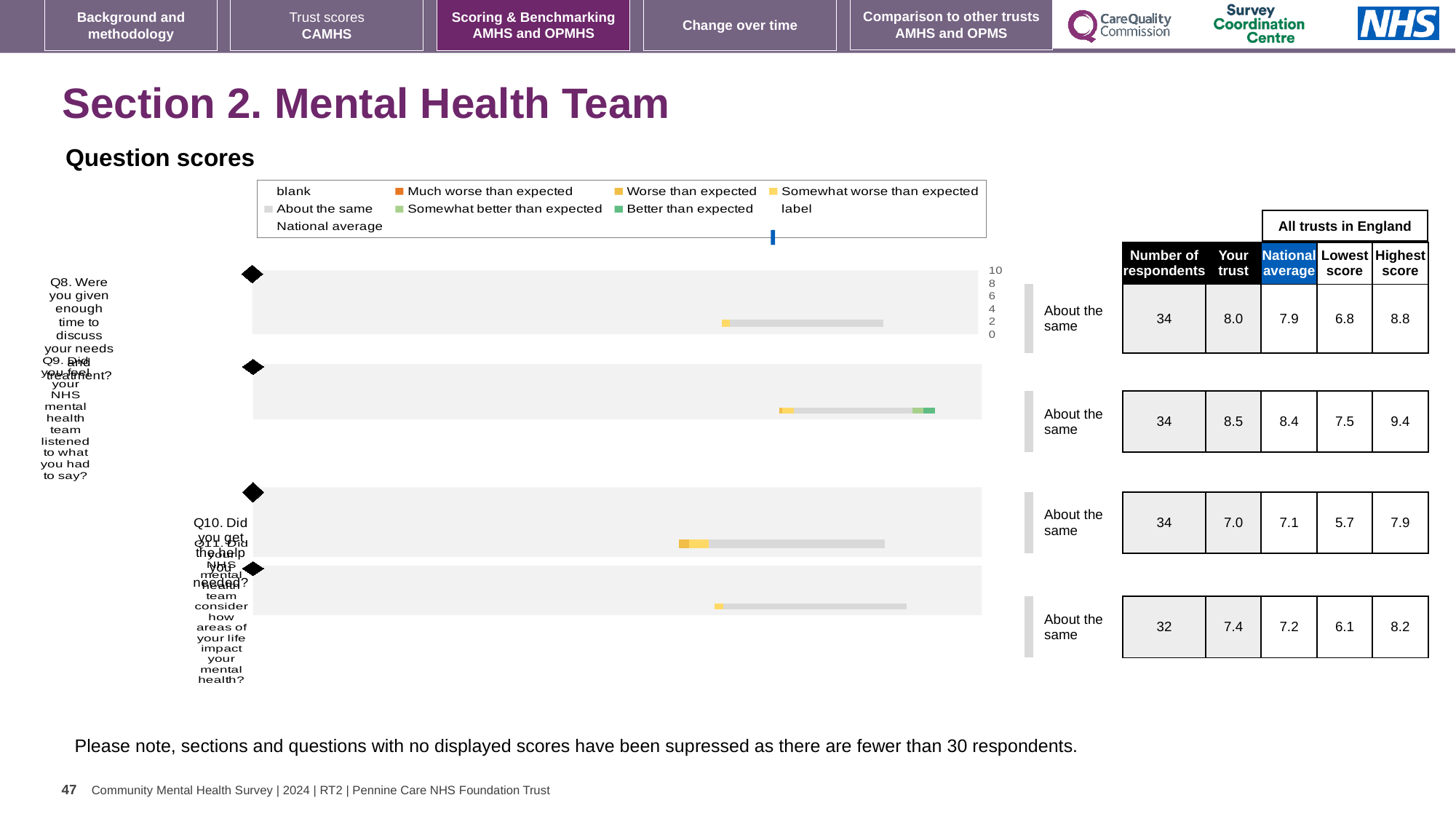
Which question has the lowest 'Your trust' score in the table? Q10 What is the national average score for Q9 shown in the table? 8.4 What benchmark label is shown for Q8 in the chart? About the same Which question has the highest 'Your trust' score in the table? Q9 How many questions (categories) are plotted in the question scores chart? 4 In the table next to the chart, what is the 'Your trust' score for Q8? 8.0 What kind of chart is used to show the question scores on this slide? bar chart What is the lowest score among all trusts in England for Q10? 5.7 How many respondents are listed for Q11? 32 In the legend, what colour represents 'Much worse than expected'? orange What is the difference between the highest score and the lowest score for Q9? 1.9 Which is larger, the 'Your trust' score for Q9 or for Q10? Q9